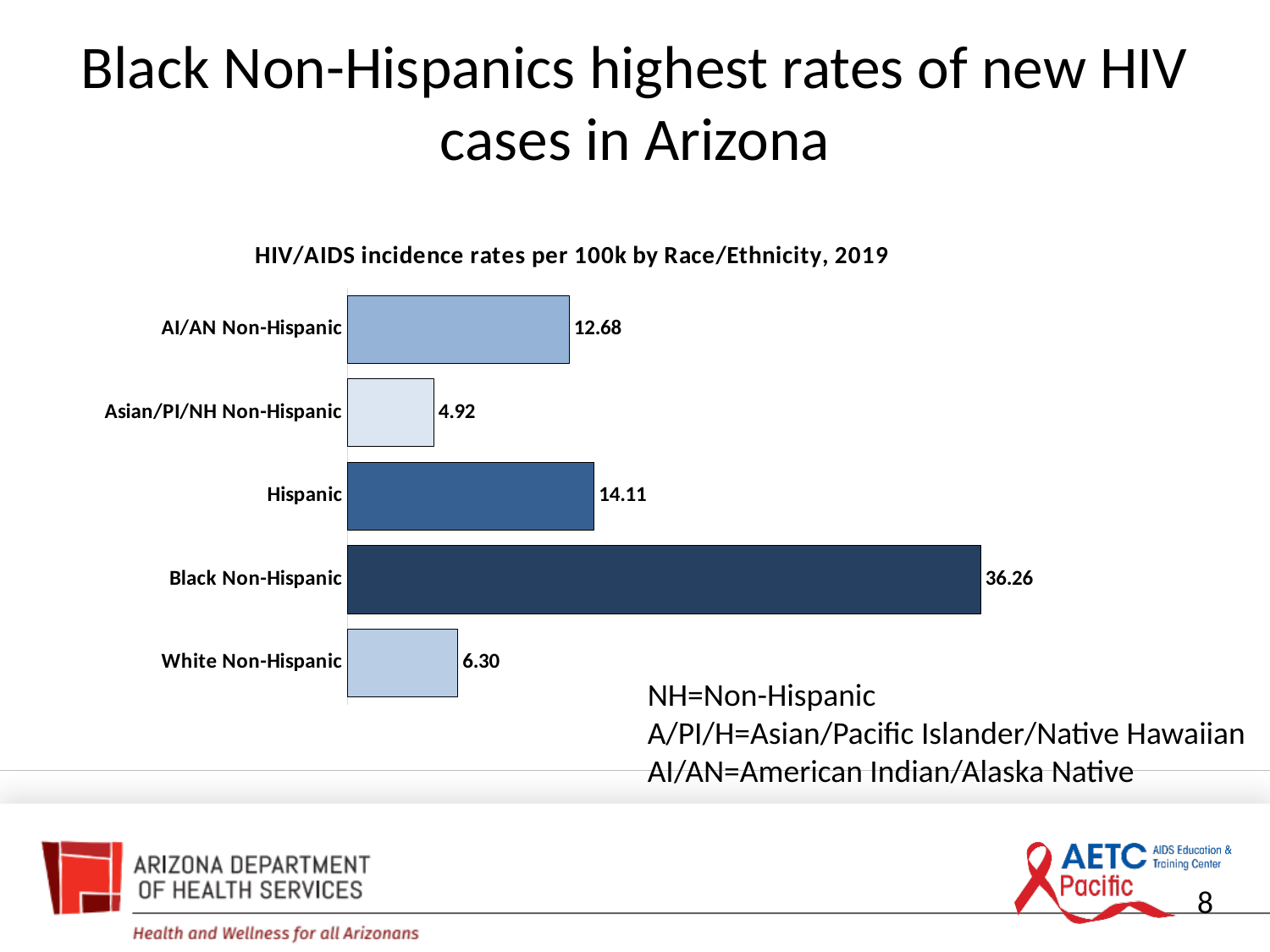
Which race/ethnicity group has the highest HIV/AIDS incidence rate? Black Non-Hispanic Which has a higher incidence rate, Hispanic or AI/AN Non-Hispanic? Hispanic What type of chart is shown on the slide? Bar chart What is the HIV/AIDS incidence rate per 100k for Asian/PI/NH Non-Hispanic? 4.92 What is the HIV/AIDS incidence rate per 100k for Black Non-Hispanic? 36.26 What is the HIV/AIDS incidence rate per 100k for AI/AN Non-Hispanic? 12.68 Which race/ethnicity group has the lowest HIV/AIDS incidence rate? Asian/PI/NH Non-Hispanic What is the HIV/AIDS incidence rate per 100k for Hispanic? 14.11 What is the title of the chart? HIV/AIDS incidence rates per 100k by Race/Ethnicity, 2019 What is the HIV/AIDS incidence rate per 100k for White Non-Hispanic? 6.30 How many race/ethnicity categories are shown in the chart? 5 What is the difference between the incidence rates for Black Non-Hispanic and Hispanic? 22.15